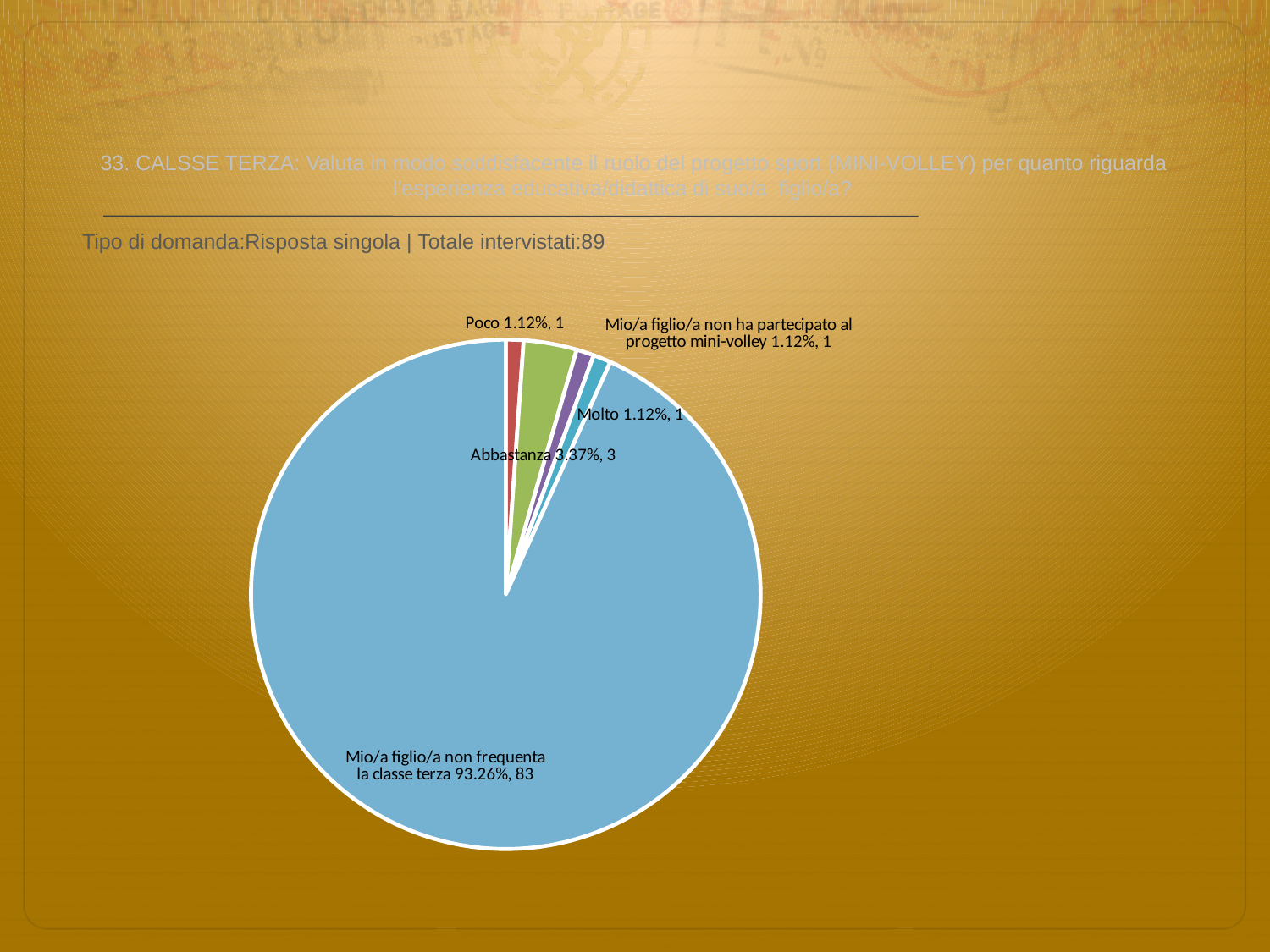
What is the difference in respondent count between "Mio/a figlio/a non frequenta la classe terza" and "Abbastanza"? 80 How many respondents chose "Mio/a figlio/a non frequenta la classe terza"? 83 What percentage share does the "Abbastanza" slice have? 3.37% What percentage share does the slice "Mio/a figlio/a non frequenta la classe terza" have? 93.26% What is the total number of respondents (Totale intervistati) stated on the slide? 89 How many respondents chose "Abbastanza"? 3 How many respondents chose "Molto"? 1 Which is larger, the count for "Abbastanza" or the count for "Molto"? Abbastanza What percentage share does the "Poco" slice have? 1.12% How many slices does the pie chart have? 5 What kind of chart is shown on the slide? pie chart Which category has the largest slice of the pie? Mio/a figlio/a non frequenta la classe terza